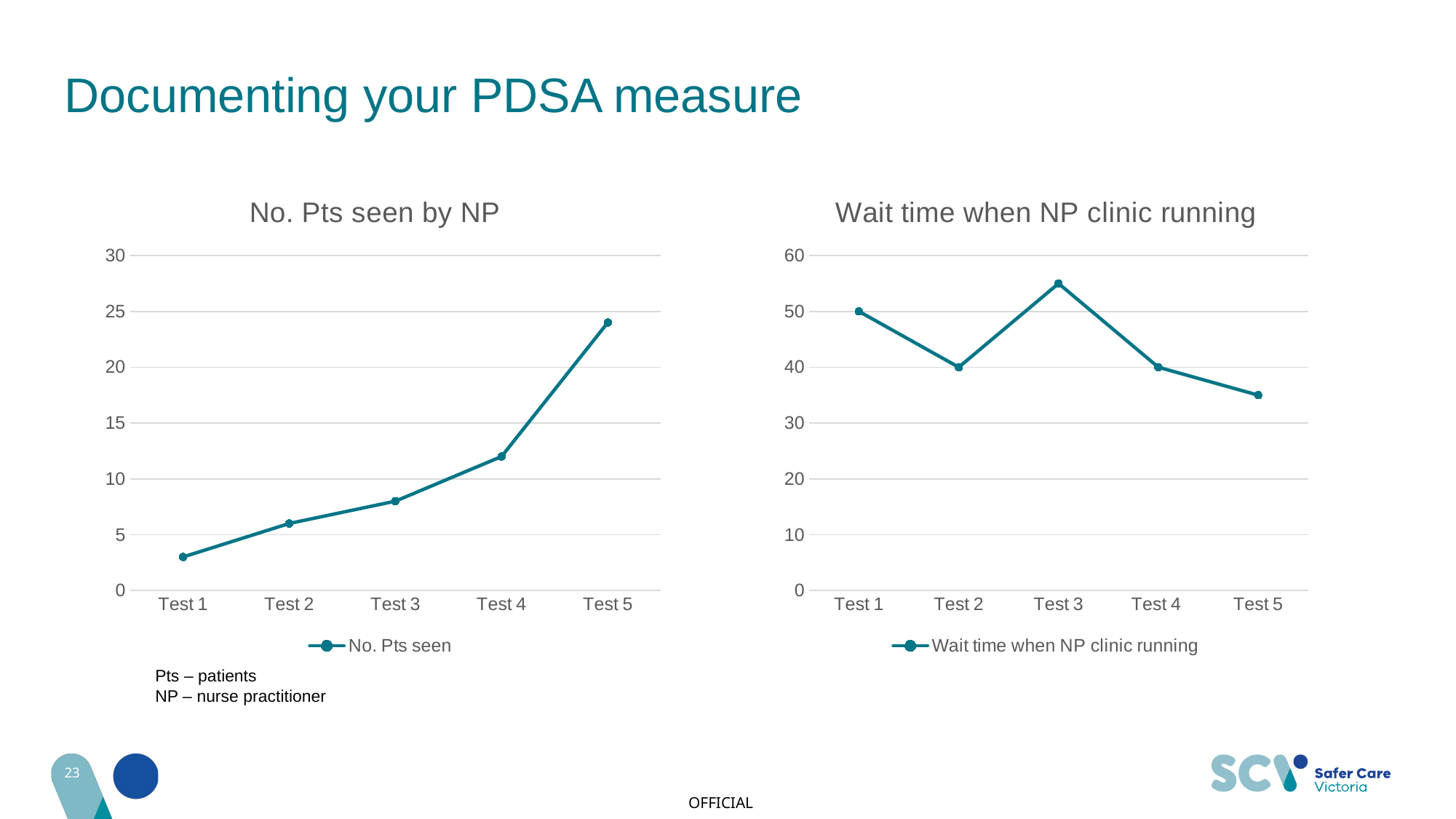
In the "Wait time when NP clinic running" chart, what is the value for Test 4? 40 In the "Wait time when NP clinic running" chart, which test has the lowest value? Test 5 In the "Wait time when NP clinic running" chart, what is the value for Test 1? 50 In the "No. Pts seen by NP" chart, is the value for Test 5 greater or less than 20? greater How many tests are plotted on the x axis of the "No. Pts seen by NP" chart? 5 In the "No. Pts seen by NP" chart, do the values rise or fall from Test 1 to Test 5? rise In the "No. Pts seen by NP" chart, which test has the highest value? Test 5 In the "No. Pts seen by NP" chart, is the value for Test 1 greater or less than 5? less What kind of chart is "No. Pts seen by NP"? line chart In the "Wait time when NP clinic running" chart, which test has the highest value? Test 3 In the "Wait time when NP clinic running" chart, what is the difference between the values for Test 1 and Test 2? 10 In the "Wait time when NP clinic running" chart, what is the value for Test 2? 40